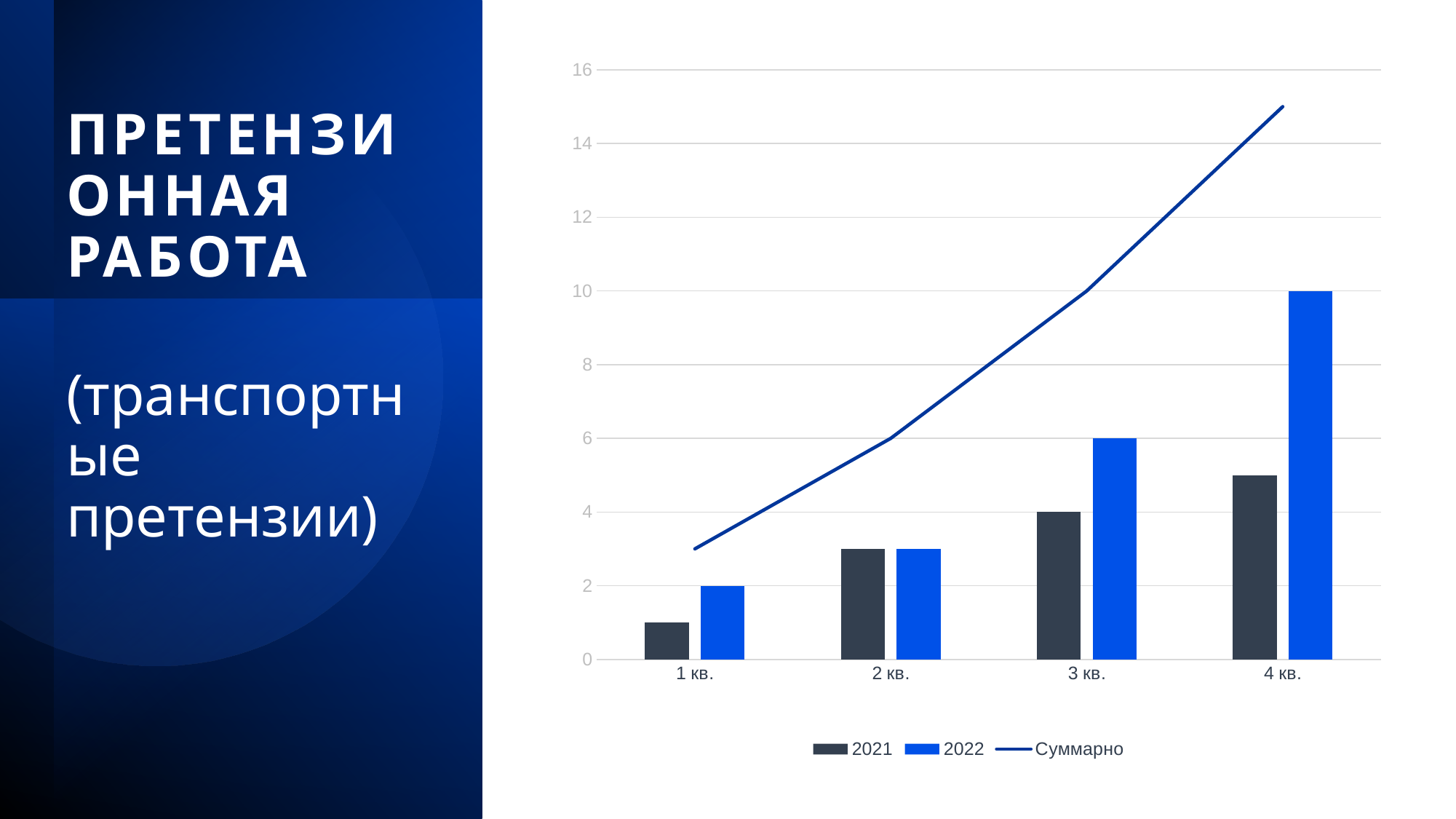
In which quarter is the 2021 value lowest? 1 кв. What is the value for 2022 in 3 кв.? 6 In which quarter is the 2022 value highest? 4 кв. How many quarters are shown on the x axis? 4 What is the value for 2022 in 4 кв.? 10 What is the value for 2021 in 3 кв.? 4 What is the difference between the 2022 values for 4 кв. and 3 кв.? 4 Is the value of the Суммарно line in 4 кв. greater or less than 14? greater How many series does the legend list? 3 Which is larger in 4 кв., the 2021 value or the 2022 value? 2022 Is the value for 2021 in 1 кв. greater or less than 2? less What is the value of the Суммарно line in 3 кв.? 10